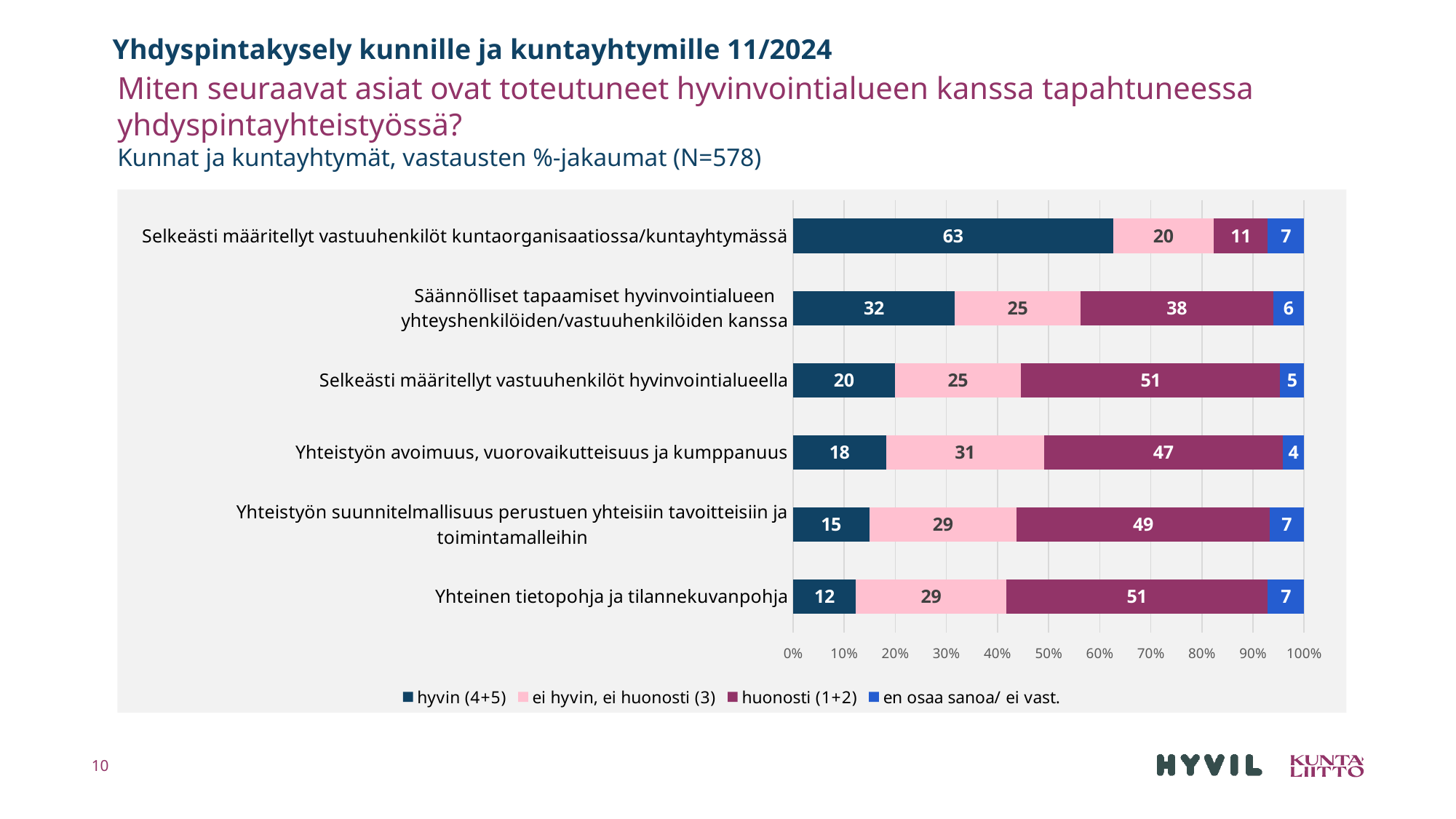
How many series does the legend list? 4 Which category has the highest "hyvin (4+5)" value? Selkeästi määritellyt vastuuhenkilöt kuntaorganisaatiossa/kuntayhtymässä Is the "hyvin (4+5)" value for "Selkeästi määritellyt vastuuhenkilöt kuntaorganisaatiossa/kuntayhtymässä" greater or less than 50%? greater Which category has the lowest "huonosti (1+2)" value? Selkeästi määritellyt vastuuhenkilöt kuntaorganisaatiossa/kuntayhtymässä What is the "en osaa sanoa/ ei vast." value for "Yhteistyön avoimuus, vuorovaikutteisuus ja kumppanuus"? 4 What kind of chart is shown on the slide? Stacked bar chart What is the "huonosti (1+2)" value for "Säännölliset tapaamiset hyvinvointialueen yhteyshenkilöiden/vastuuhenkilöiden kanssa"? 38 What is the difference between the "hyvin (4+5)" values for "Selkeästi määritellyt vastuuhenkilöt kuntaorganisaatiossa/kuntayhtymässä" and "Säännölliset tapaamiset hyvinvointialueen yhteyshenkilöiden/vastuuhenkilöiden kanssa"? 31 What percentage answered "hyvin (4+5)" for "Selkeästi määritellyt vastuuhenkilöt kuntaorganisaatiossa/kuntayhtymässä"? 63 How many categories are shown in the chart? 6 Which has a larger "ei hyvin, ei huonosti (3)" value: "Yhteistyön avoimuus, vuorovaikutteisuus ja kumppanuus" or "Säännölliset tapaamiset hyvinvointialueen yhteyshenkilöiden/vastuuhenkilöiden kanssa"? Yhteistyön avoimuus, vuorovaikutteisuus ja kumppanuus Which category has the lowest "hyvin (4+5)" value? Yhteinen tietopohja ja tilannekuvanpohja